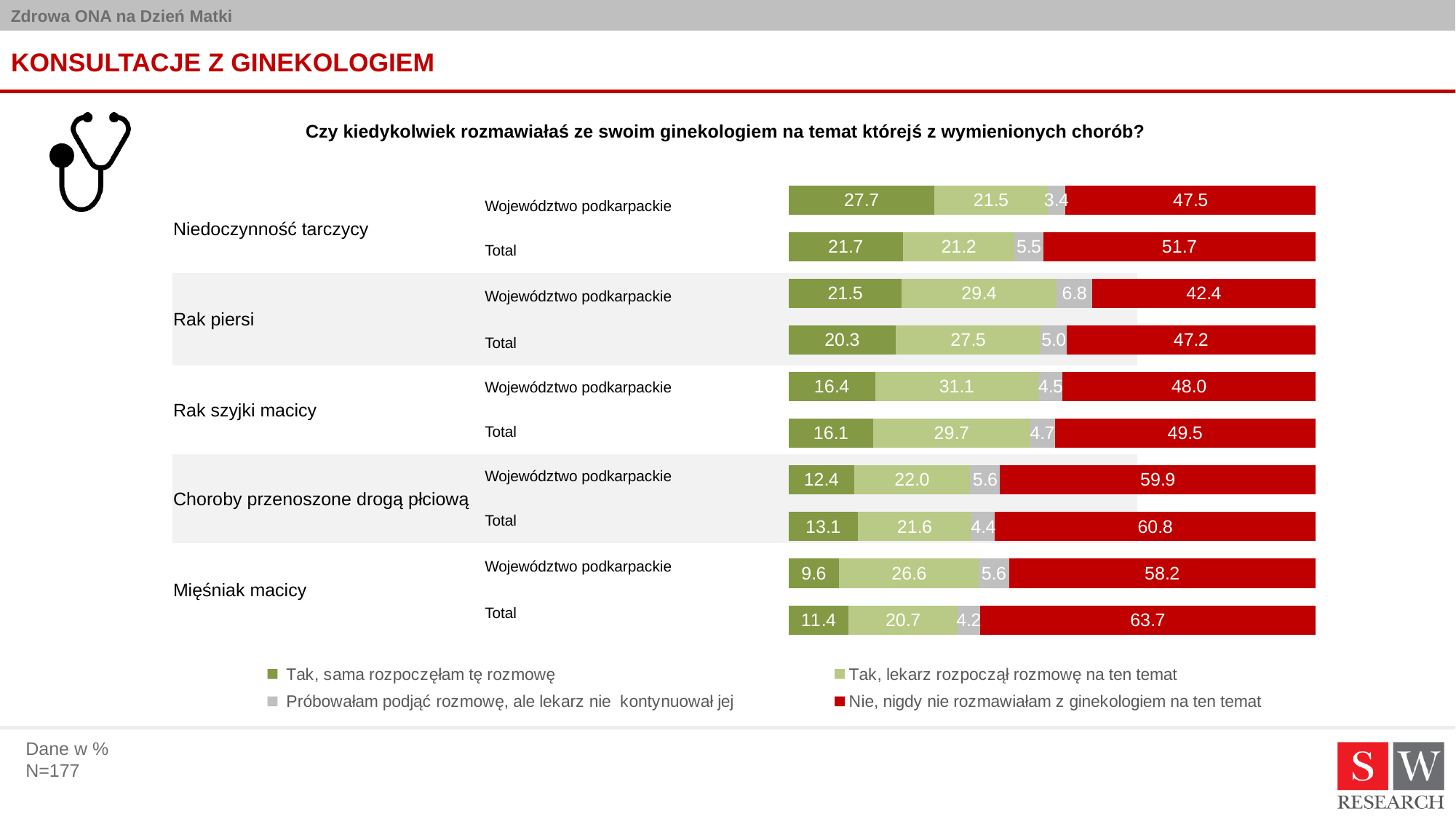
For Rak szyjki macicy, which is larger for "Tak, lekarz rozpoczął rozmowę na ten temat": Województwo podkarpackie or Total? Województwo podkarpackie What is the value for "Nie, nigdy nie rozmawiałam z ginekologiem na ten temat" for Niedoczynność tarczycy, Województwo podkarpackie? 47.5 How many bars are shown in the chart? 10 How many series does the legend list? 4 What kind of chart is shown on the slide? Stacked bar chart Which bar has the lowest value for "Tak, sama rozpoczęłam tę rozmowę"? Mięśniak macicy, Województwo podkarpackie Which bar has the highest value for "Tak, lekarz rozpoczął rozmowę na ten temat"? Rak szyjki macicy, Województwo podkarpackie What is the total of the stacked bar for Rak szyjki macicy, Województwo podkarpackie? 100.0 For Choroby przenoszone drogą płciową, what is the difference between Total and Województwo podkarpackie for "Nie, nigdy nie rozmawiałam z ginekologiem na ten temat"? 0.9 What is the value for "Tak, lekarz rozpoczął rozmowę na ten temat" for Rak piersi, Total? 27.5 Which bar has the highest value for "Nie, nigdy nie rozmawiałam z ginekologiem na ten temat"? Mięśniak macicy, Total What is the value for "Próbowałam podjąć rozmowę, ale lekarz nie kontynuował jej" for Mięśniak macicy, Total? 4.2